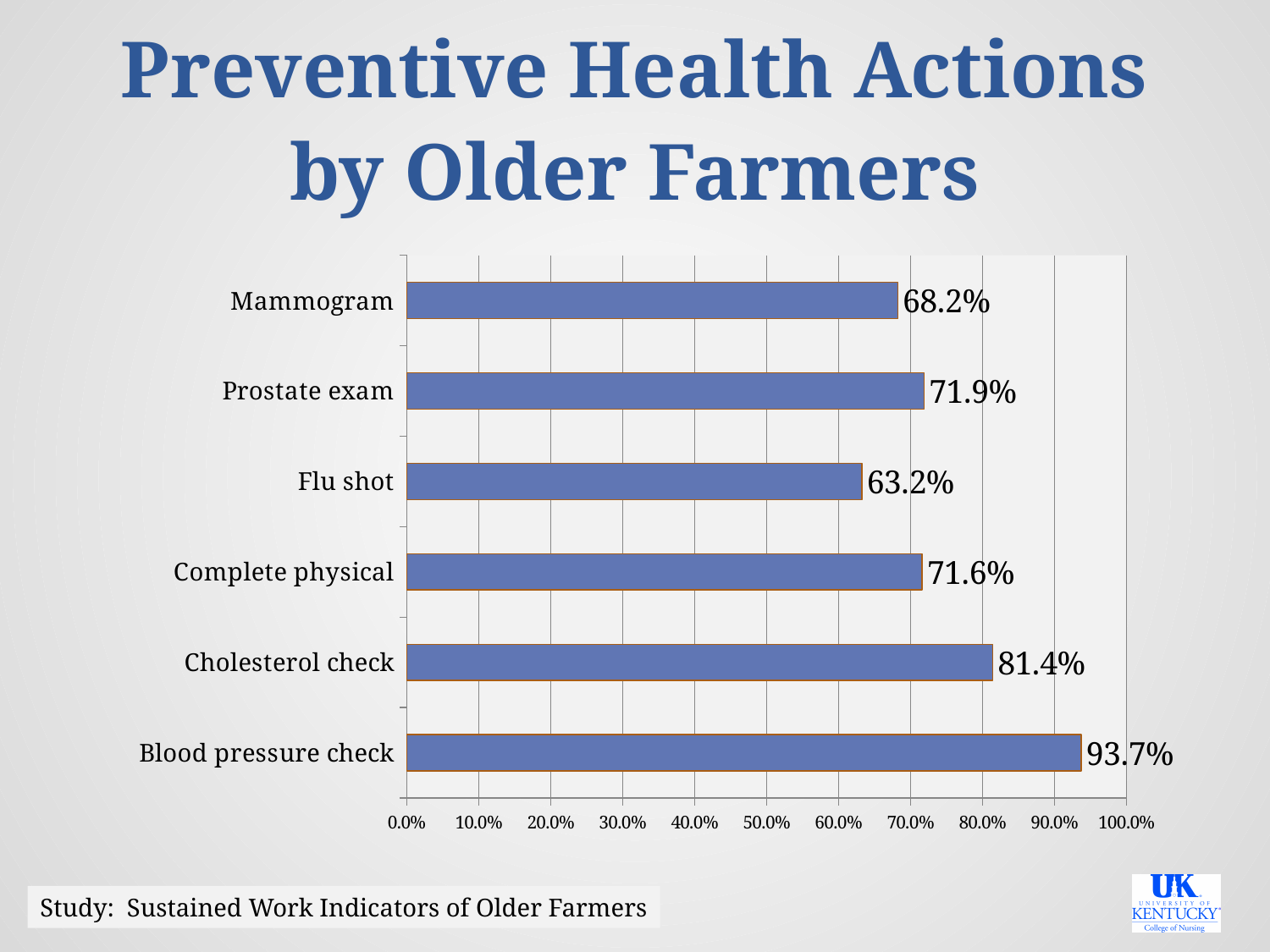
What is the title of the slide? Preventive Health Actions by Older Farmers Which preventive health action has the highest percentage? Blood pressure check What kind of chart is shown on the slide? Bar chart What percentage of older farmers had a mammogram? 68.2% Which preventive health action has the lowest percentage? Flu shot How many preventive health actions are shown in the chart? 6 What is the value for Cholesterol check? 81.4% What is the value for Flu shot? 63.2% Which is larger, Prostate exam or Mammogram? Prostate exam What is the difference between Mammogram and Flu shot? 5.0% What is the difference between Blood pressure check and Cholesterol check? 12.3% Is the value for Complete physical greater or less than 80.0%? less